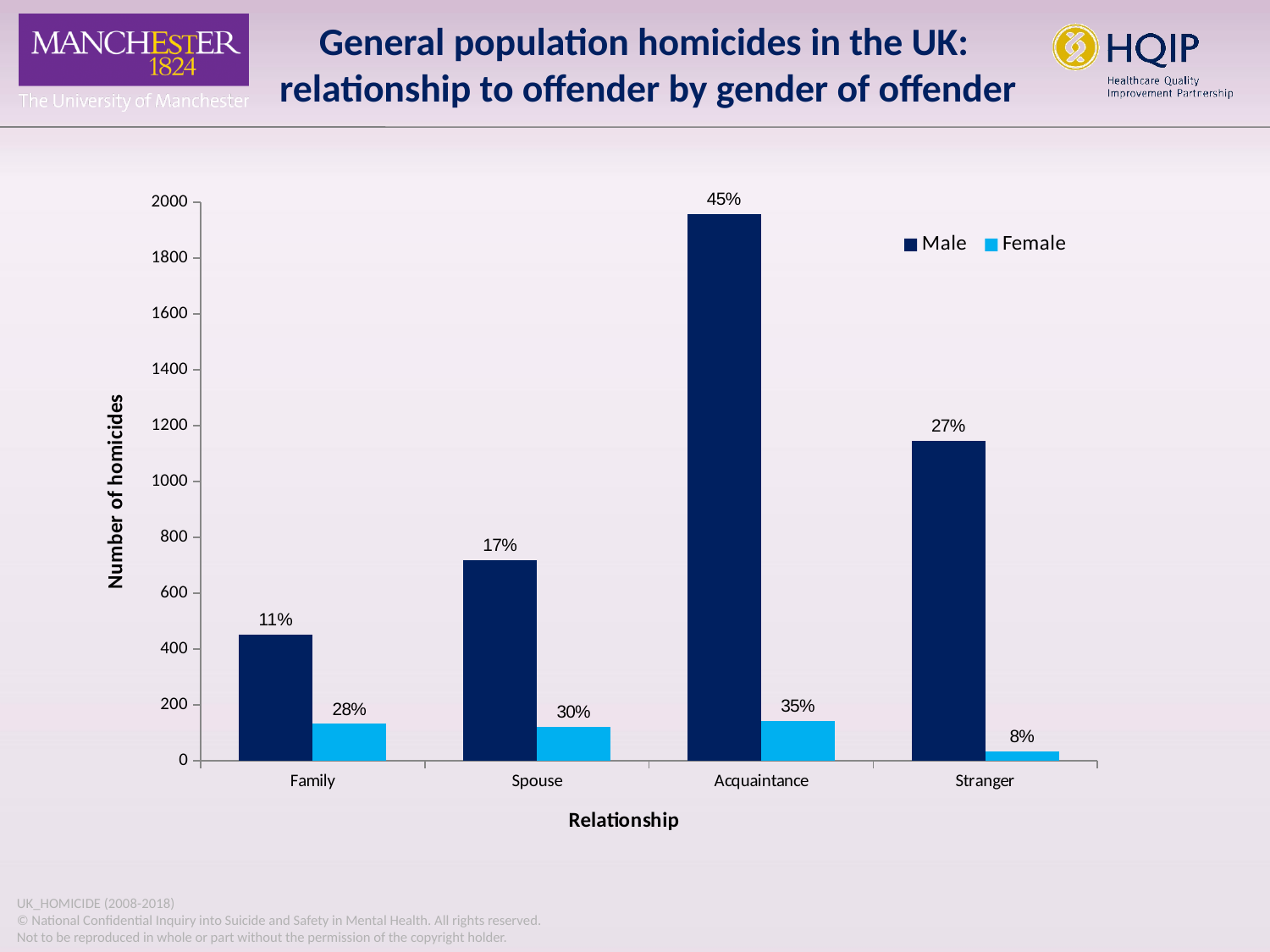
What percentage label is shown on the Male bar for Acquaintance? 45% Which is larger, the Male bar for Spouse or the Male bar for Family? Male bar for Spouse Which relationship category has the tallest Male bar? Acquaintance How many relationship categories are shown on the x axis? 4 How many series does the legend list? 2 What percentage label is shown on the Female bar for Stranger? 8% Is the number of homicides for Female offenders in the Family category greater or less than 200? less What percentage label is shown on the Female bar for Spouse? 30% What percentage label is shown on the Male bar for Family? 11% Is the number of homicides for Male offenders in the Acquaintance category greater or less than 1800? greater Is the number of homicides for Male offenders in the Stranger category greater or less than 1000? greater Which relationship category has the shortest Female bar? Stranger